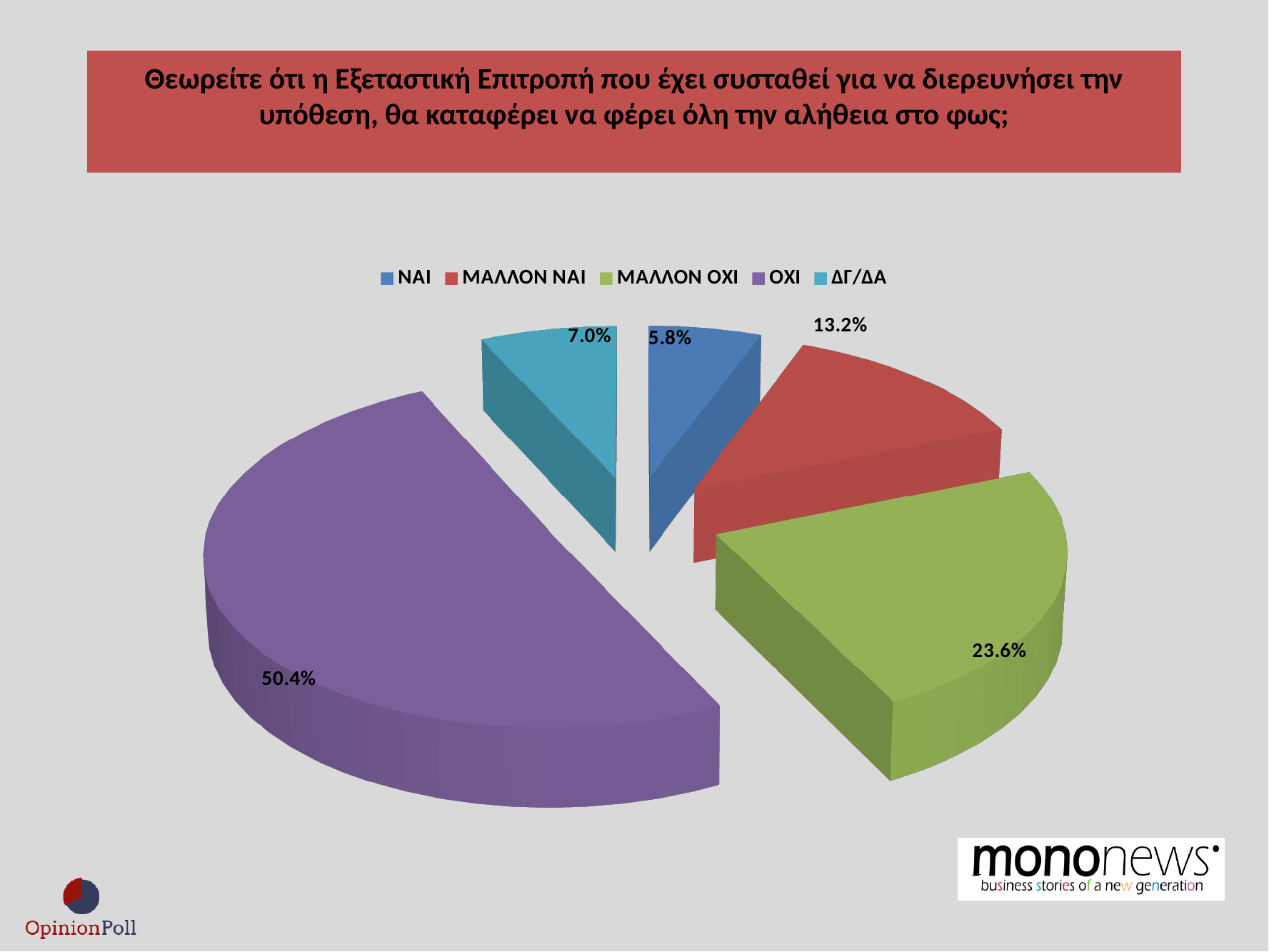
What percentage of respondents answered ΜΑΛΛΟΝ ΟΧΙ? 23.6% Which is larger, the share for ΜΑΛΛΟΝ ΝΑΙ or the share for ΔΓ/ΔΑ? ΜΑΛΛΟΝ ΝΑΙ Which response has the smallest share of the pie? ΝΑΙ What percentage of respondents answered ΜΑΛΛΟΝ ΝΑΙ? 13.2% Which response has the largest share of the pie? ΟΧΙ What is the difference in percentage points between ΟΧΙ and ΜΑΛΛΟΝ ΟΧΙ? 26.8 What percentage of respondents answered ΔΓ/ΔΑ? 7.0% What colour is the ΟΧΙ slice in the pie chart? purple What percentage of respondents answered ΟΧΙ? 50.4% What percentage of respondents answered ΝΑΙ? 5.8% How many slices does the pie chart have? 5 What kind of chart is shown on the slide? pie chart